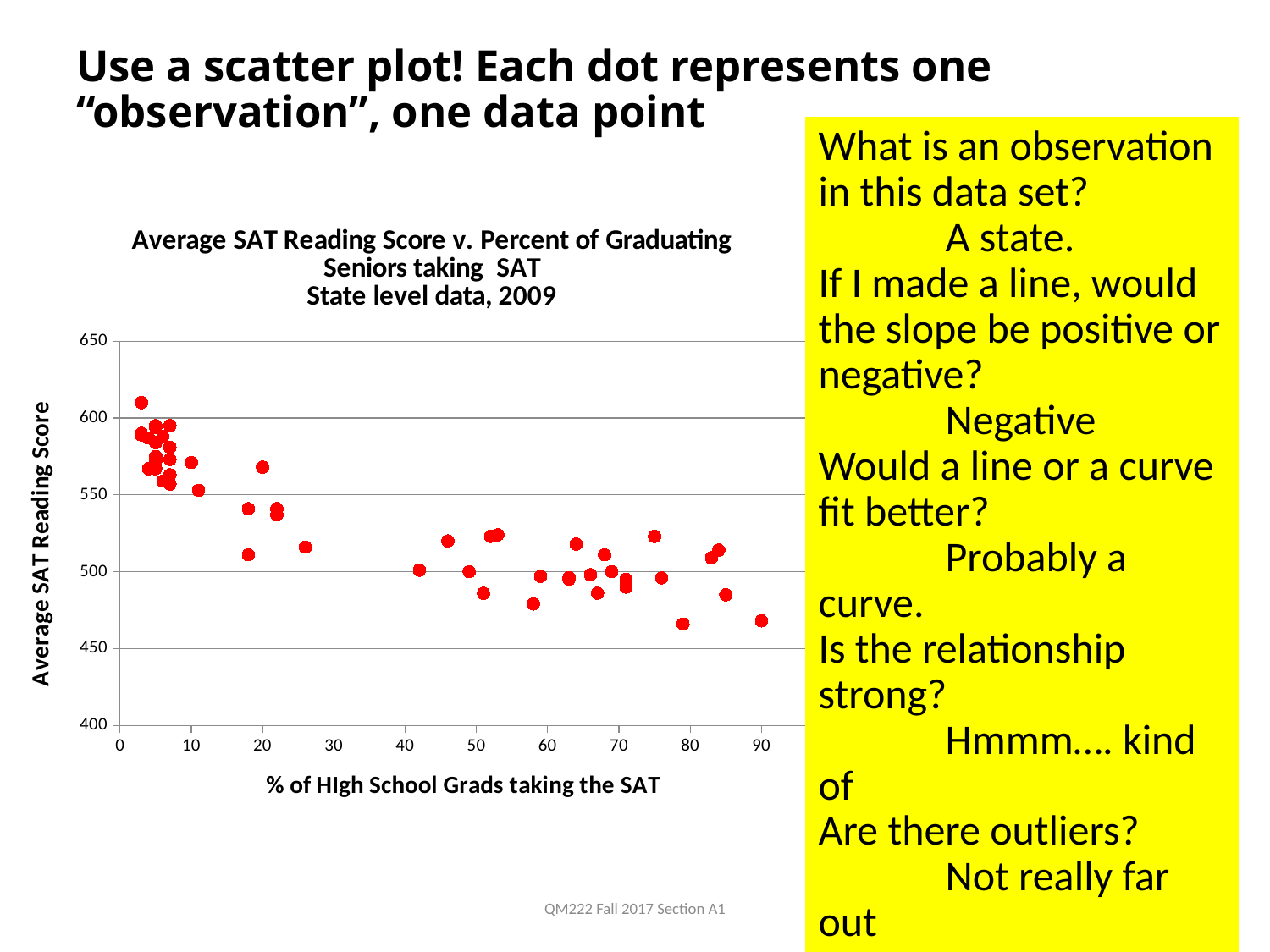
What is the label on the x axis of the chart? % of HIgh School Grads taking the SAT Are the points plotted around 20% of grads taking the SAT above or below a reading score of 500? above As the percent of high school grads taking the SAT increases along the x axis, do the average SAT reading scores generally rise or fall? fall What kind of chart is shown on the slide? scatter plot Is the average SAT reading score for the point at about 90% of grads taking the SAT greater or less than 500? less Are the average SAT reading scores for the points near 3% of grads taking the SAT greater or less than 550? greater Does the lowest average SAT reading score on the chart occur at a low or a high percentage of grads taking the SAT? high Does the highest average SAT reading score on the chart occur at a low or a high percentage of grads taking the SAT? low What is the title of the chart? Average SAT Reading Score v. Percent of Graduating Seniors taking SAT State level data, 2009 Which group of states has higher average SAT reading scores: those with about 5% of grads taking the SAT or those with about 80%? about 5%